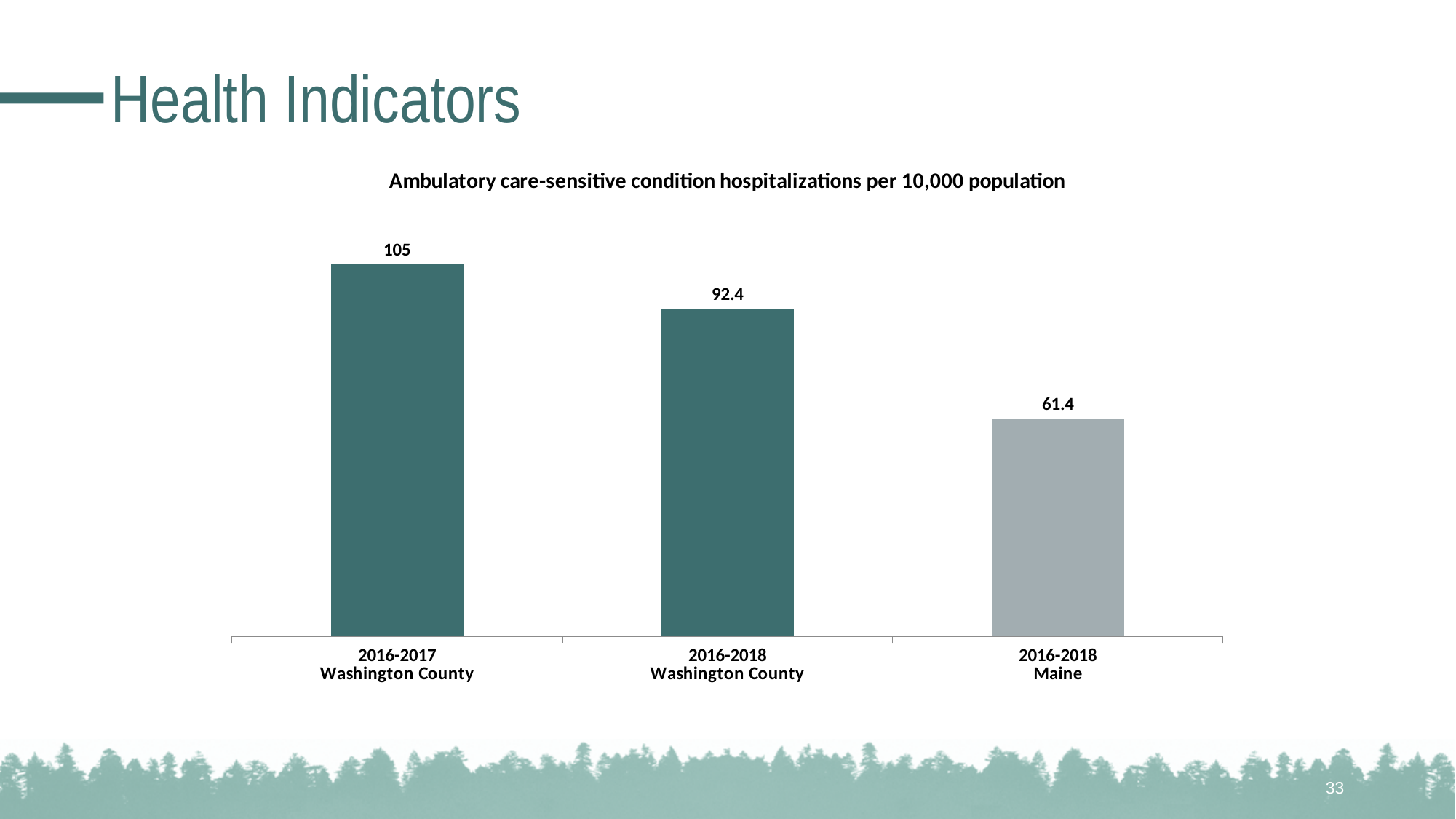
Which category has the lowest value? 2016-2018 Maine What is the value for 2016-2017 Washington County? 105 What is the title of the chart? Ambulatory care-sensitive condition hospitalizations per 10,000 population Which category has the highest value? 2016-2017 Washington County What kind of chart is shown on the slide? bar chart What is the value for 2016-2018 Maine? 61.4 How many categories are shown in the chart? 3 What is the difference between the 2016-2018 Washington County value and the 2016-2018 Maine value? 31 Do the values rise or fall from left to right along the x axis? fall What is the value for 2016-2018 Washington County? 92.4 Which is larger, the value for 2016-2018 Washington County or the value for 2016-2018 Maine? 2016-2018 Washington County What is the difference between the 2016-2017 Washington County value and the 2016-2018 Washington County value? 12.6